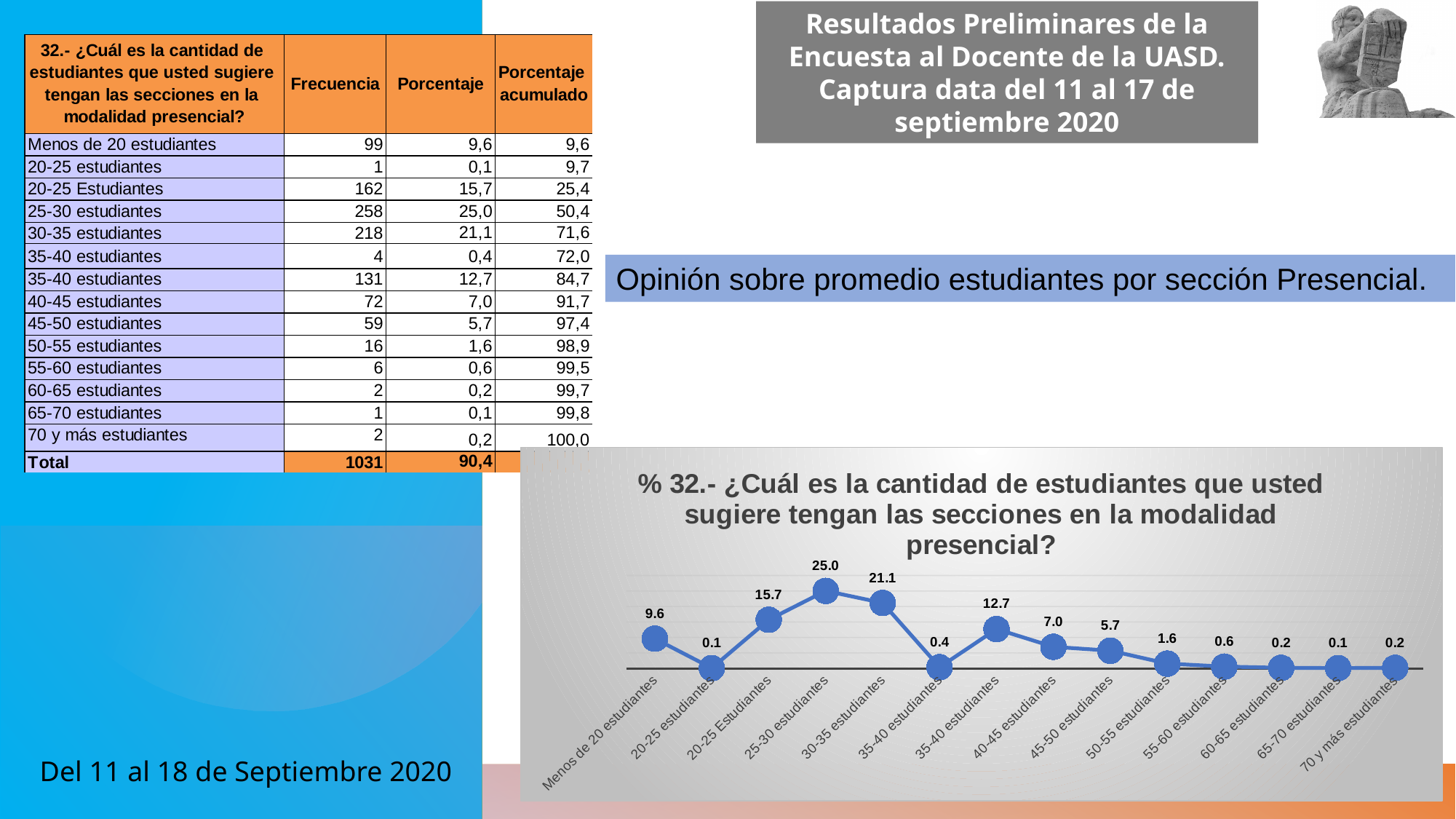
What type of chart is shown on the slide? line chart What is the difference between the values for "25-30 estudiantes" and "30-35 estudiantes"? 3.9 How many data points are plotted in the chart? 14 What is the value for "Menos de 20 estudiantes" in the chart? 9.6 What is the difference between the values for "Menos de 20 estudiantes" and "40-45 estudiantes"? 2.6 Which has a larger value, "40-45 estudiantes" or "45-50 estudiantes"? 40-45 estudiantes Do the values rise or fall from "45-50 estudiantes" to "55-60 estudiantes"? fall What is the value for "50-55 estudiantes" in the chart? 1.6 What is the value for "25-30 estudiantes" in the chart? 25.0 Which category has the highest value in the chart? 25-30 estudiantes What is the value for "30-35 estudiantes" in the chart? 21.1 What is the value for "40-45 estudiantes" in the chart? 7.0